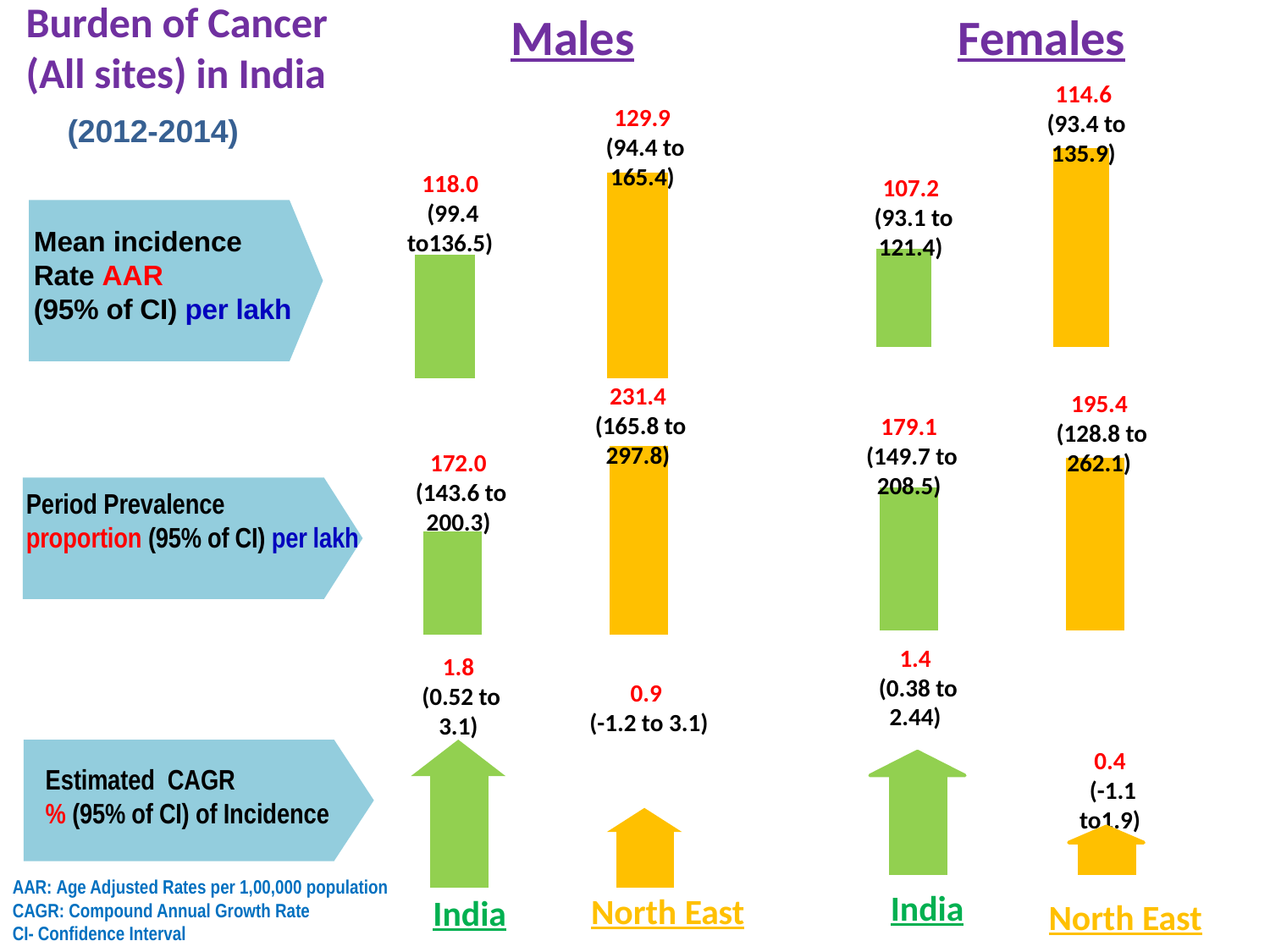
In the Period Prevalence proportion row, which is larger for Females: India or North East? North East In the Mean incidence Rate AAR row, what is the value for Females in the North East? 114.6 In the Period Prevalence proportion row, what is the difference between the Males North East value and the Males India value? 59.4 In the Estimated CAGR row, which group has the lowest value? Females, North East In the Mean incidence Rate AAR row, which group has the highest value? Males, North East In the Estimated CAGR row, what is the value for Females in India? 1.4 In the Mean incidence Rate AAR row, what is the difference between the Males North East value and the Males India value? 11.9 In the Period Prevalence proportion row, what is the value for Males in the North East? 231.4 In the Estimated CAGR row, which is larger for Males: India or North East? India What colour are the bars representing India? Green In the Mean incidence Rate AAR row, which group has the lowest value? Females, India In the Mean incidence Rate AAR row, what is the value for Males in India? 118.0